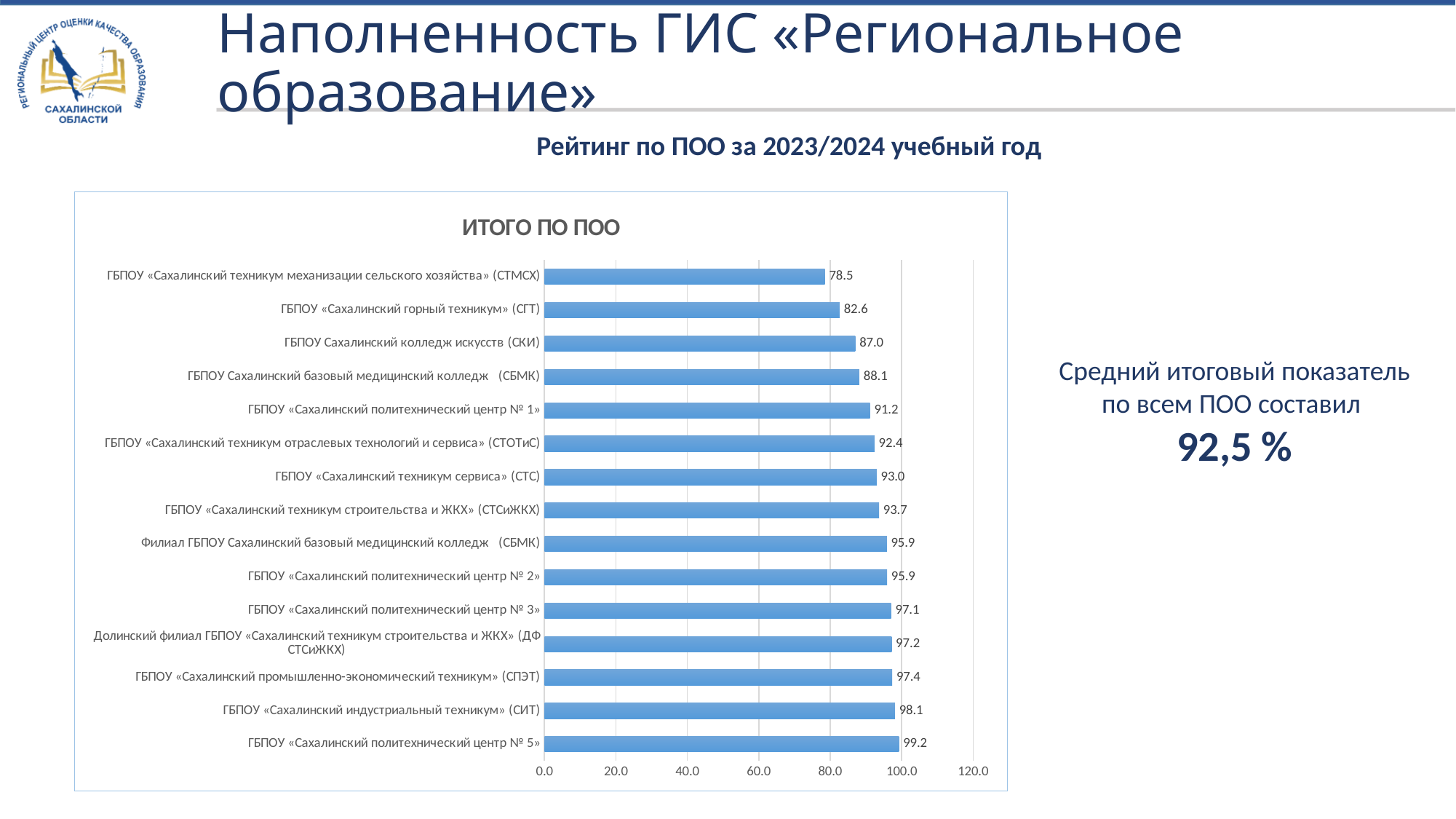
What kind of chart is shown on the slide? bar chart Is the value for ГБПОУ «Сахалинский техникум механизации сельского хозяйства» (СТМСХ) greater or less than 80.0? less What is the difference between the values for ГБПОУ «Сахалинский политехнический центр № 5» and ГБПОУ «Сахалинский техникум механизации сельского хозяйства» (СТМСХ)? 20.7 What is the title of the chart? ИТОГО ПО ПОО What is the value for ГБПОУ Сахалинский колледж искусств (СКИ)? 87.0 Which institution has the lowest value in the chart? ГБПОУ «Сахалинский техникум механизации сельского хозяйства» (СТМСХ) What is the value for ГБПОУ «Сахалинский индустриальный техникум» (СИТ)? 98.1 What is the value for ГБПОУ «Сахалинский техникум механизации сельского хозяйства» (СТМСХ)? 78.5 Which has the larger value: ГБПОУ «Сахалинский горный техникум» (СГТ) or ГБПОУ Сахалинский колледж искусств (СКИ)? ГБПОУ Сахалинский колледж искусств (СКИ) What is the difference between the values for ГБПОУ «Сахалинский промышленно-экономический техникум» (СПЭТ) and ГБПОУ «Сахалинский техникум сервиса» (СТС)? 4.4 Which institution has the highest value in the chart? ГБПОУ «Сахалинский политехнический центр № 5» How many institutions are shown in the chart? 15